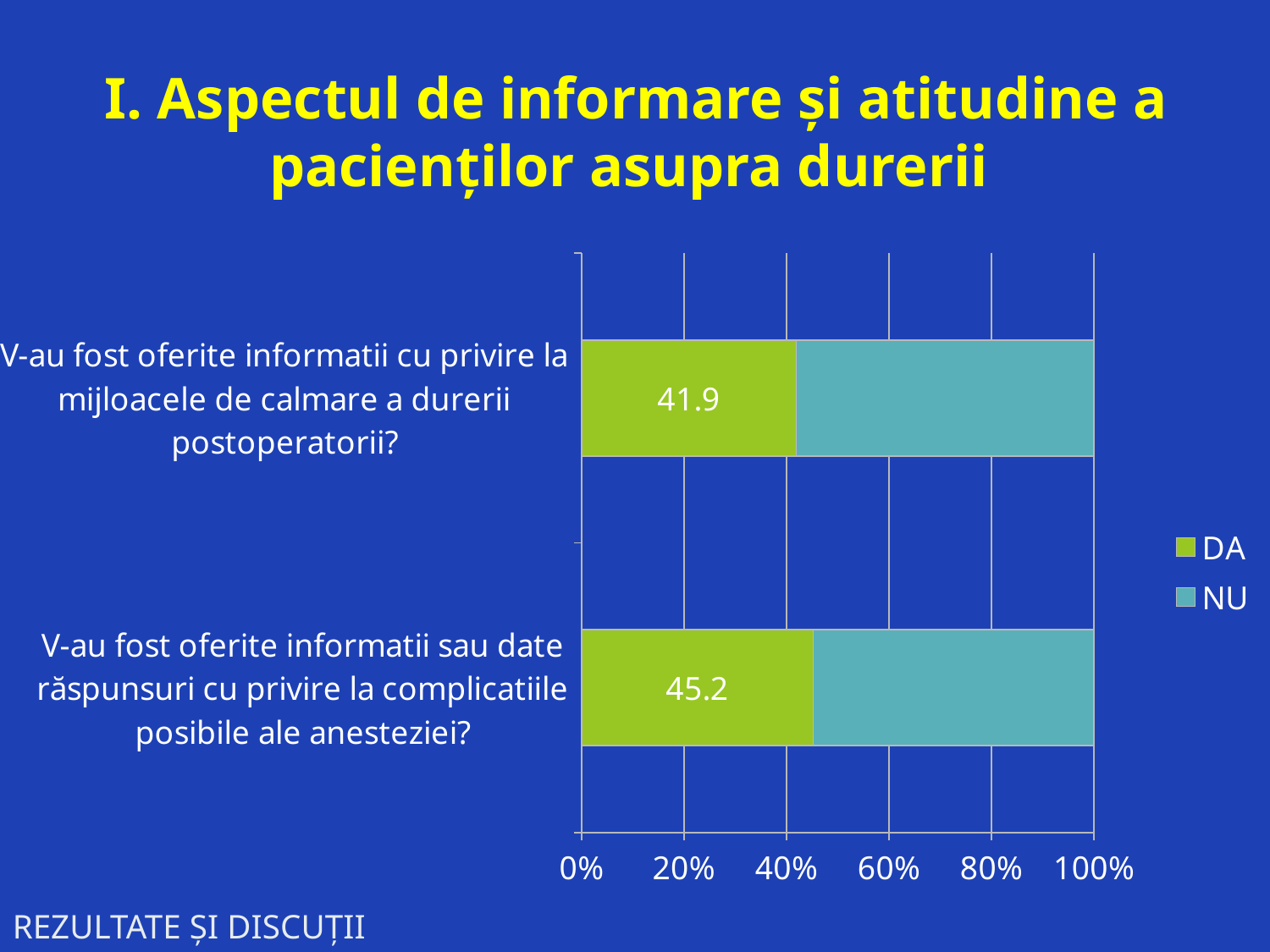
Which question has the lower DA value? V-au fost oferite informatii cu privire la mijloacele de calmare a durerii postoperatorii? What is the DA value for the question "V-au fost oferite informatii sau date răspunsuri cu privire la complicatiile posibile ale anesteziei?"? 45.2 How many series does the legend list? 2 Which question has the higher DA value? V-au fost oferite informatii sau date răspunsuri cu privire la complicatiile posibile ale anesteziei? What kind of chart is shown on the slide? Stacked bar chart Is the NU share for the question about mijloacele de calmare a durerii postoperatorii greater or less than 50%? greater How many questions (categories) are shown in the chart? 2 Which series is shown in green in the chart? DA Is the DA share for the question about mijloacele de calmare a durerii postoperatorii greater or less than 60%? less What is the DA value for the question "V-au fost oferite informatii cu privire la mijloacele de calmare a durerii postoperatorii?"? 41.9 Is the DA value for the question about complicatiile posibile ale anesteziei larger or smaller than the DA value for the question about mijloacele de calmare a durerii postoperatorii? larger What is the difference between the DA values of the two questions? 3.3